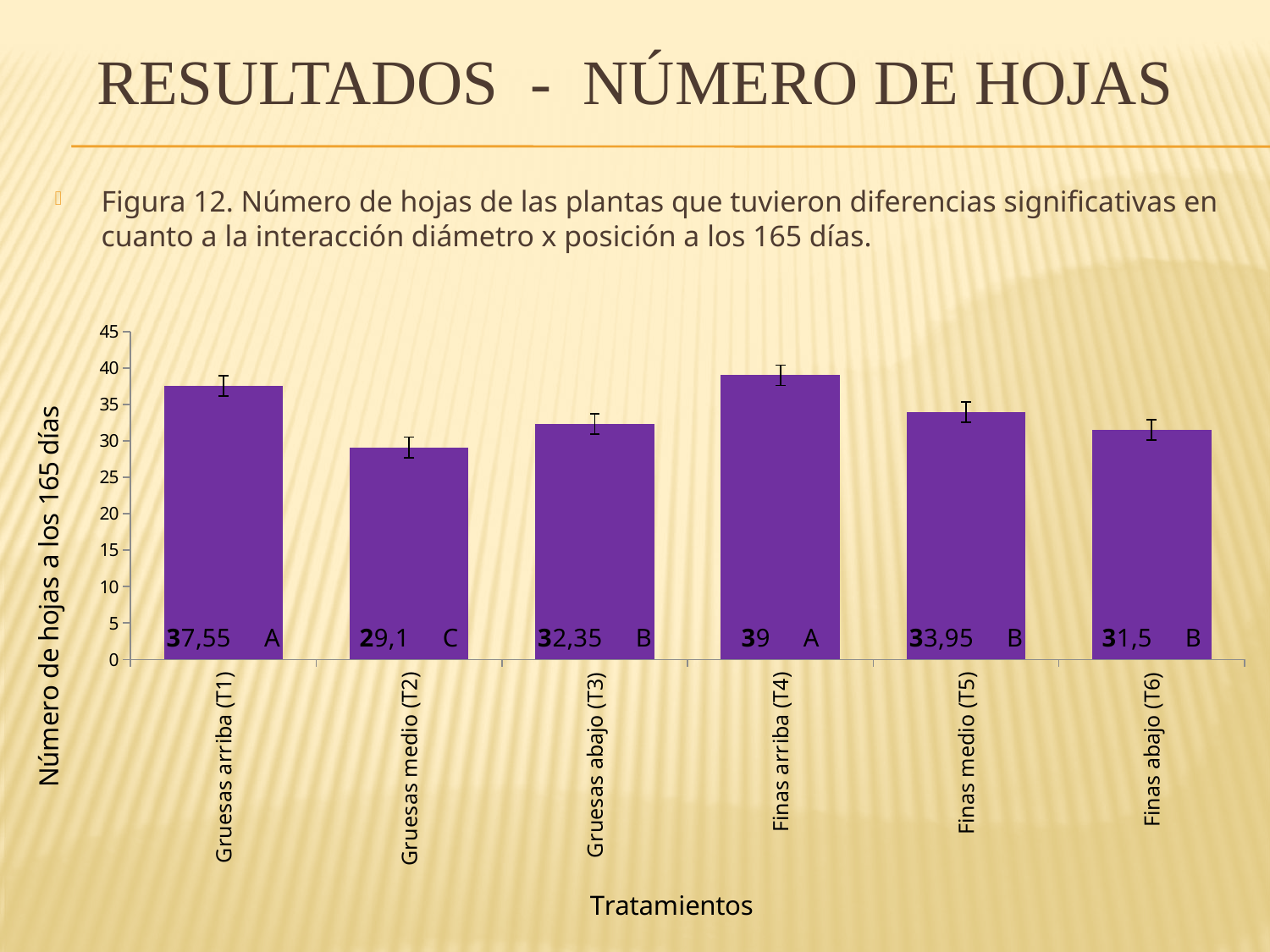
How many treatments are shown on the x axis? 6 Which is larger, the value for Gruesas abajo (T3) or the value for Finas abajo (T6)? Gruesas abajo (T3) Which treatment has the lowest number of leaves at 165 days? Gruesas medio (T2) What is the difference between the values for Finas arriba (T4) and Gruesas medio (T2)? 9,9 What statistical grouping letter is shown for Gruesas medio (T2)? C What is the value for Finas medio (T5)? 33,95 Which treatment has the highest number of leaves at 165 days? Finas arriba (T4) Is the value for Finas arriba (T4) greater or less than 35? greater What is the value for Gruesas medio (T2)? 29,1 What is the value for Gruesas arriba (T1)? 37,55 What is the label of the y axis? Número de hojas a los 165 días What kind of chart is shown on the slide? bar chart